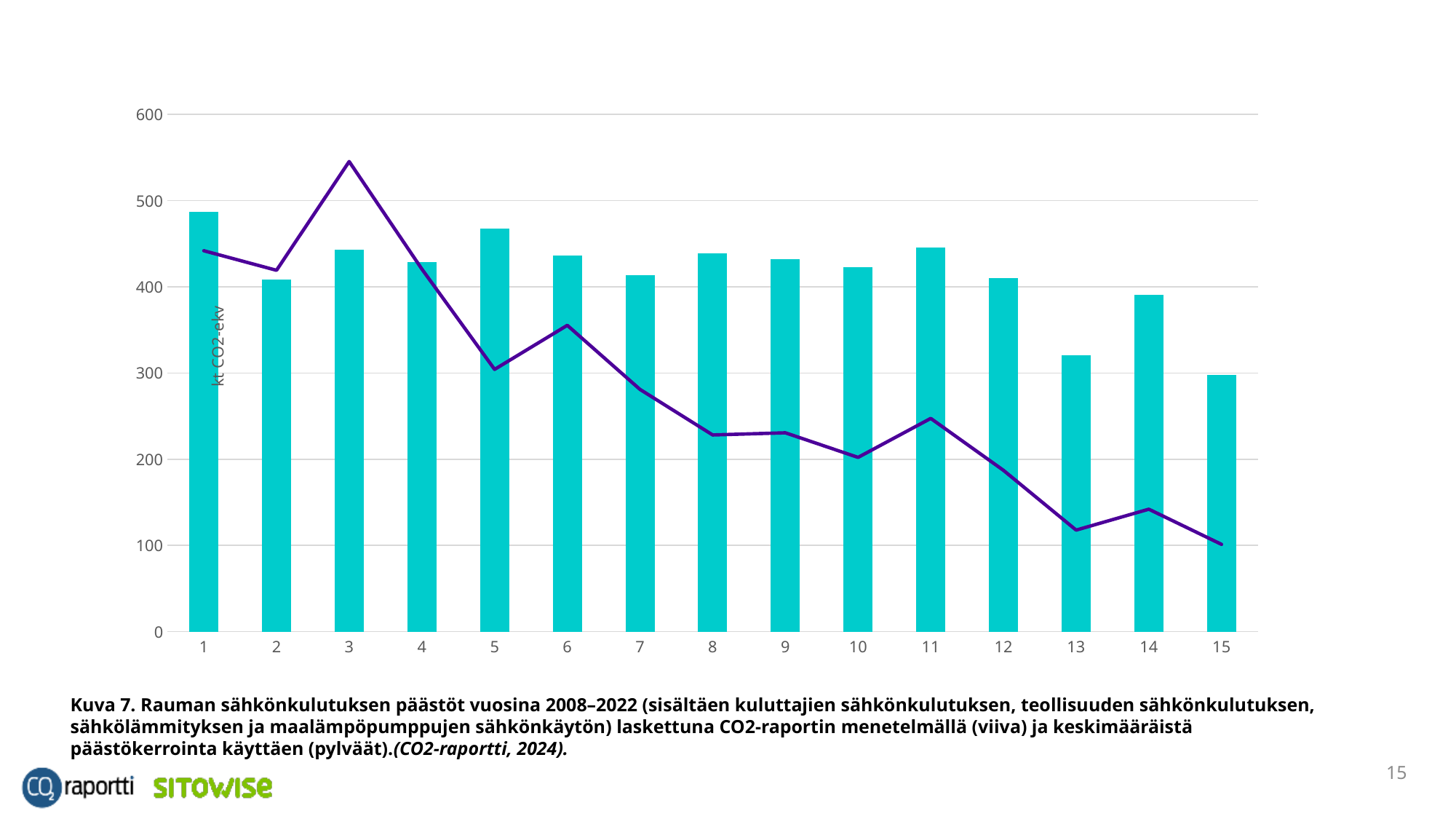
Is the bar value for category 13 greater or less than 400? less Which is larger, the bar for category 1 or the bar for category 15? Category 1 Which category has the shortest bar? 15 How many categories are shown on the x axis? 15 Is the line value at category 7 greater or less than 300? less Is the line value at category 3 greater or less than 500? greater What is the label on the vertical axis? kt CO2-ekv What kind of chart is shown on the slide? A combined bar and line chart Which category has the tallest bar? 1 Does the line generally rise or fall from category 1 to category 15? Fall At which category does the line reach its highest point? 3